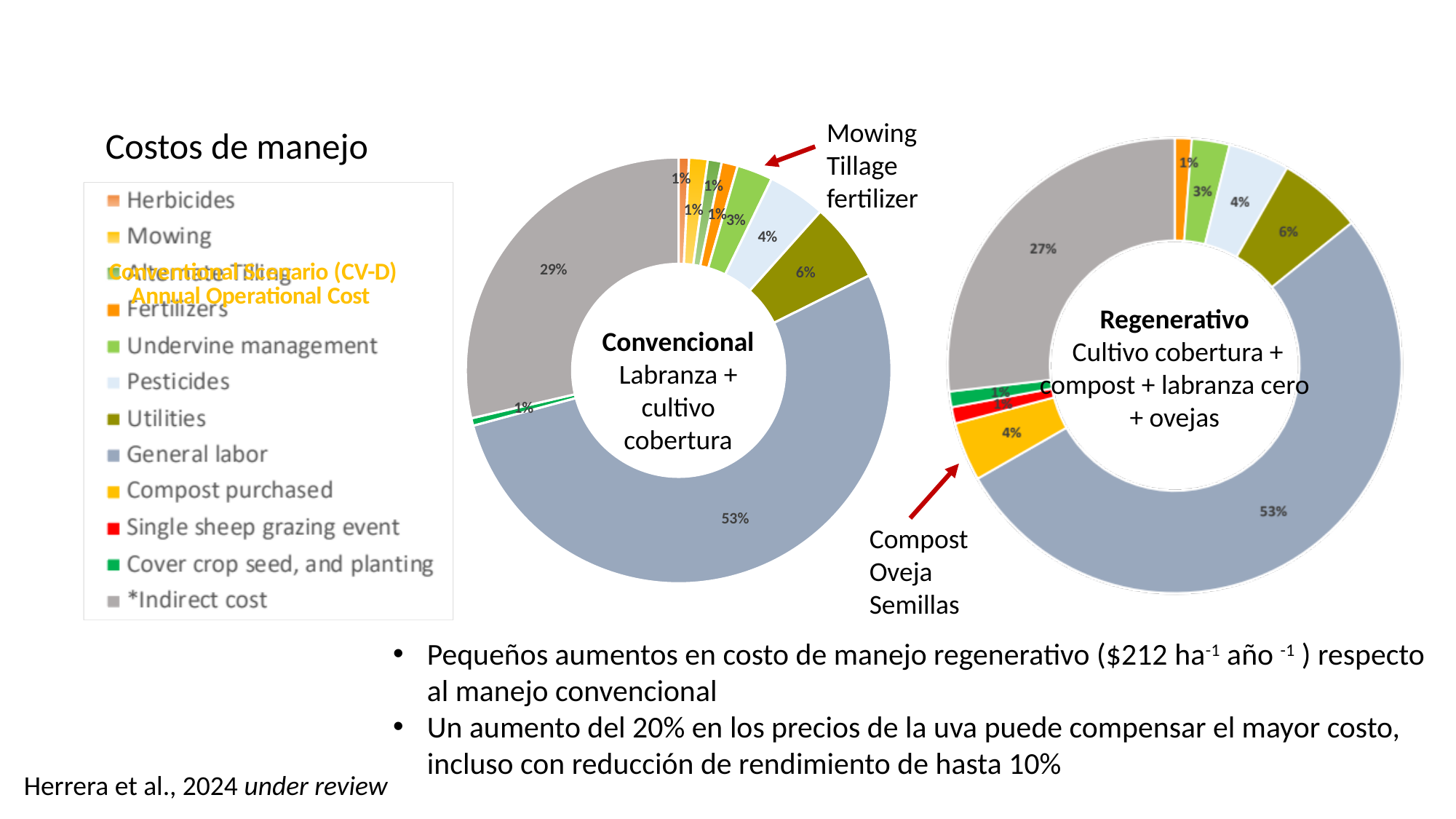
In the Convencional chart, which category has the largest share? General labor What is the title of the slide? Costos de manejo In the Regenerativo chart, what share does Utilities (olive slice) have? 6% In the Regenerativo chart, what share does Compost purchased (yellow slice) have? 4% In the Convencional chart, which is larger: the Utilities share or the Pesticides share? Utilities What is the difference between the *Indirect cost share in the Convencional chart (29%) and in the Regenerativo chart (27%)? 2% In the Convencional chart, what share does *Indirect cost (gray slice) have? 29% In the Regenerativo chart, which category has the largest share? General labor What kind of chart is the Convencional chart? Donut (pie) chart